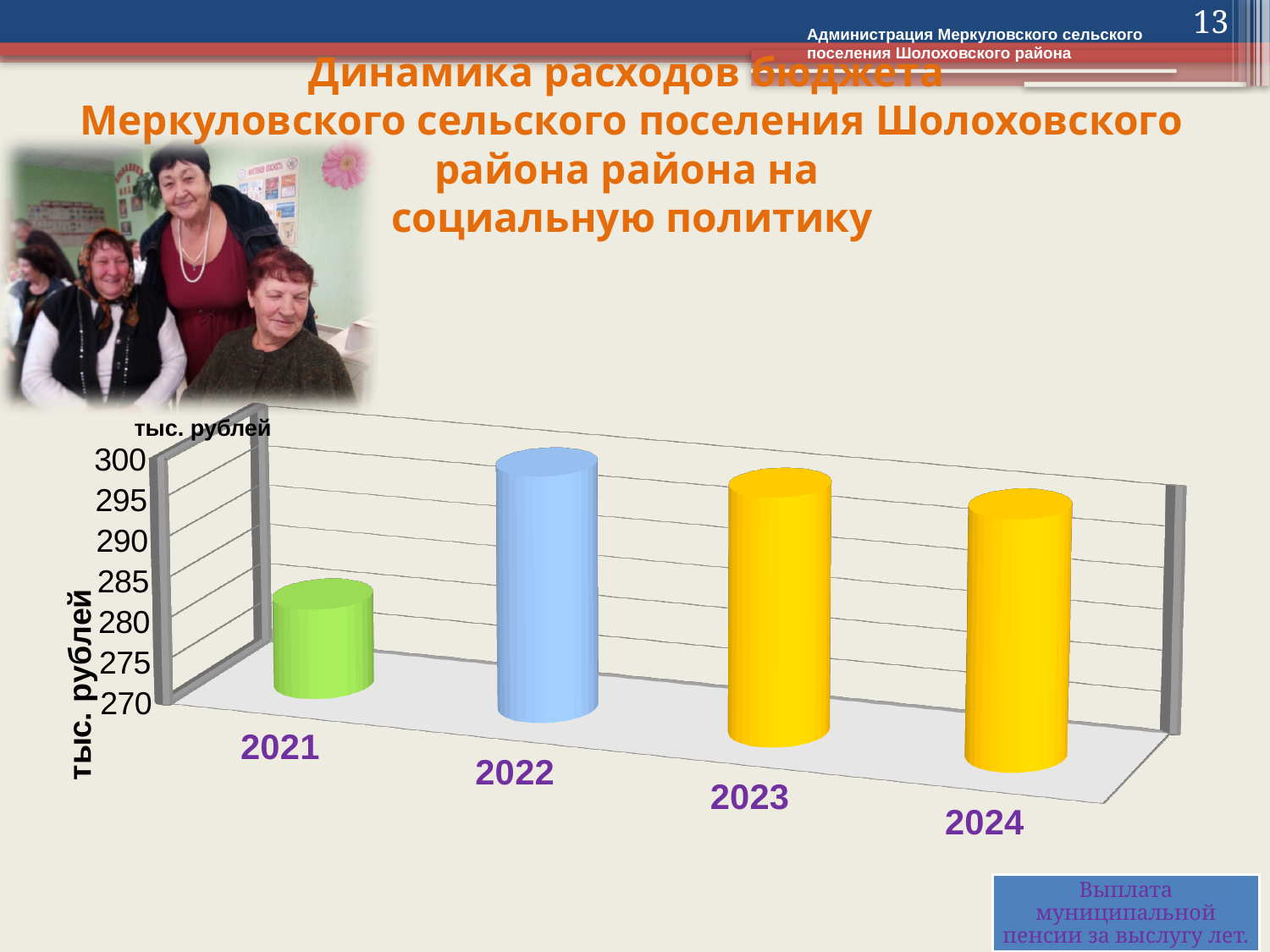
Is the value for 2021 greater or less than 275? greater What unit is shown on the vertical axis of the chart? тыс. рублей Is the value for 2024 greater or less than 285? greater Is the value for 2021 greater or less than 290? less Which year has the lowest value on the chart? 2021 Which is larger, the value for 2021 or the value for 2022? 2022 Which is larger, the value for 2024 or the value for 2021? 2024 What kind of chart is shown on the slide? bar chart How many years (categories) are plotted on the chart? 4